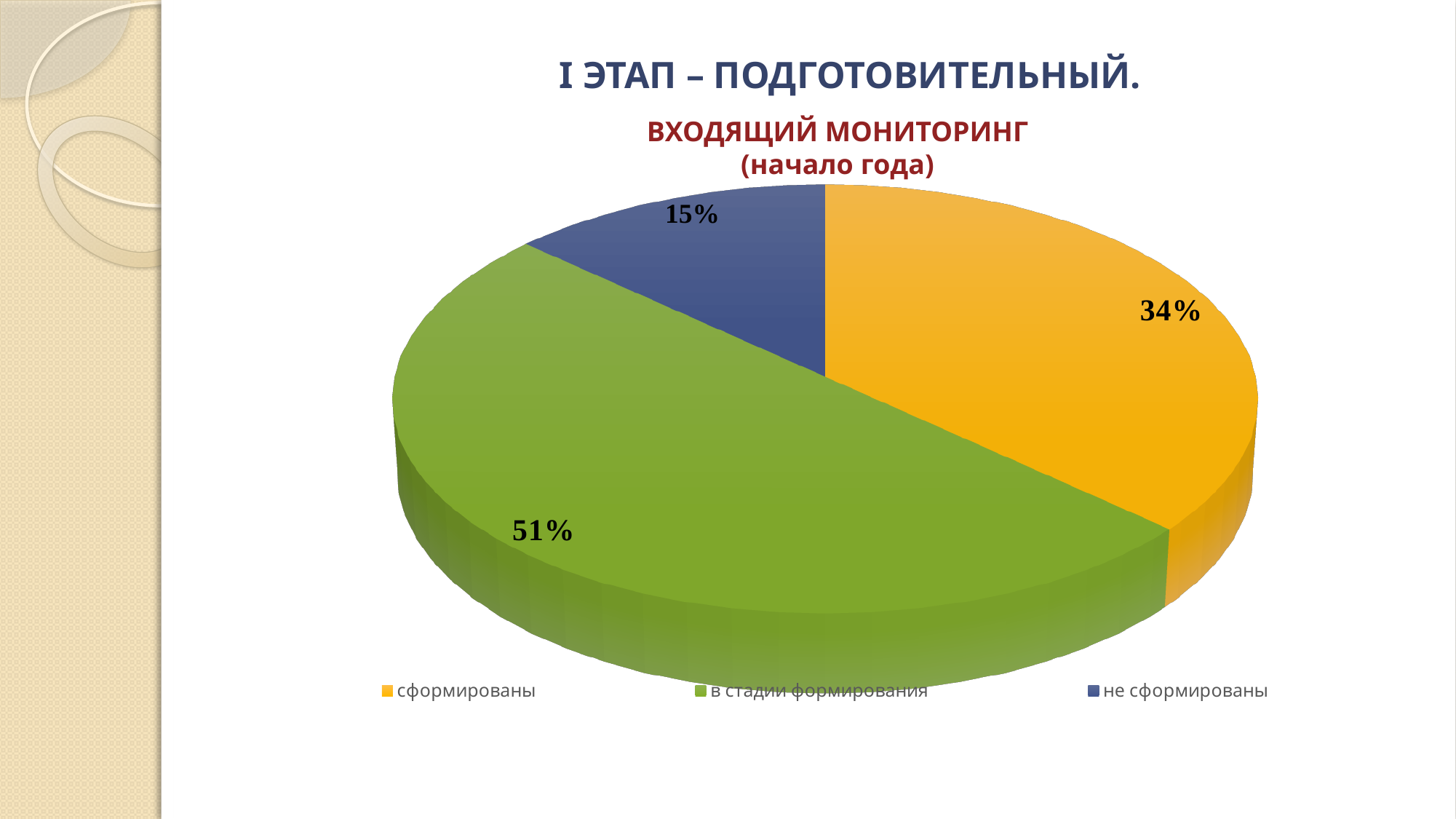
Which category has the largest slice of the pie? в стадии формирования What is the difference in percentage points between the 'в стадии формирования' slice and the 'сформированы' slice? 17 What share of the pie does the 'в стадии формирования' slice represent? 51% What is the title of the chart? ВХОДЯЩИЙ МОНИТОРИНГ (начало года) Which colour represents the 'в стадии формирования' category in the legend? green What is the difference in percentage points between the 'сформированы' slice and the 'не сформированы' slice? 19 What share of the pie does the 'сформированы' slice represent? 34% Which category has the smallest slice of the pie? не сформированы Which is larger, the 'сформированы' slice or the 'не сформированы' slice? сформированы How many slices does the pie chart have? 3 What share of the pie does the 'не сформированы' slice represent? 15% What kind of chart is shown on the slide? pie chart